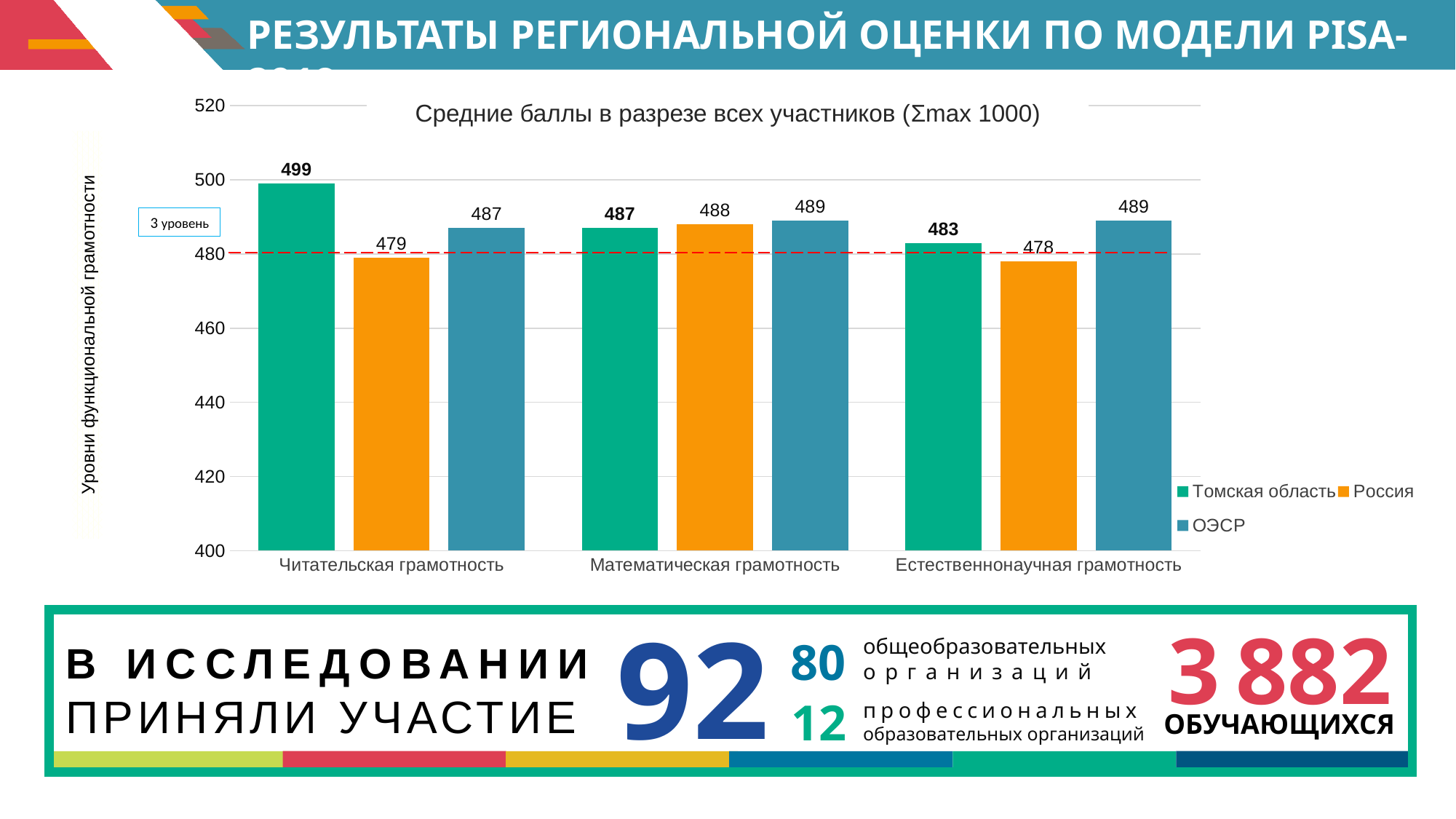
What is the value for Россия in Естественнонаучная грамотность? 478 What is the title of the chart? Средние баллы в разрезе всех участников (Σmax 1000) What is the value for ОЭСР in Математическая грамотность? 489 How many categories are shown on the x axis? 3 What is the value for Томская область in Читательская грамотность? 499 Which series has the lowest value in Читательская грамотность? Россия Is the value for Россия in Читательская грамотность greater or less than 480? less Which is larger in Естественнонаучная грамотность: Томская область or ОЭСР? ОЭСР Which category has the highest value for Томская область? Читательская грамотность What kind of chart is shown? bar chart What is the difference between Томская область and Россия in Читательская грамотность? 20 How many series does the legend list? 3